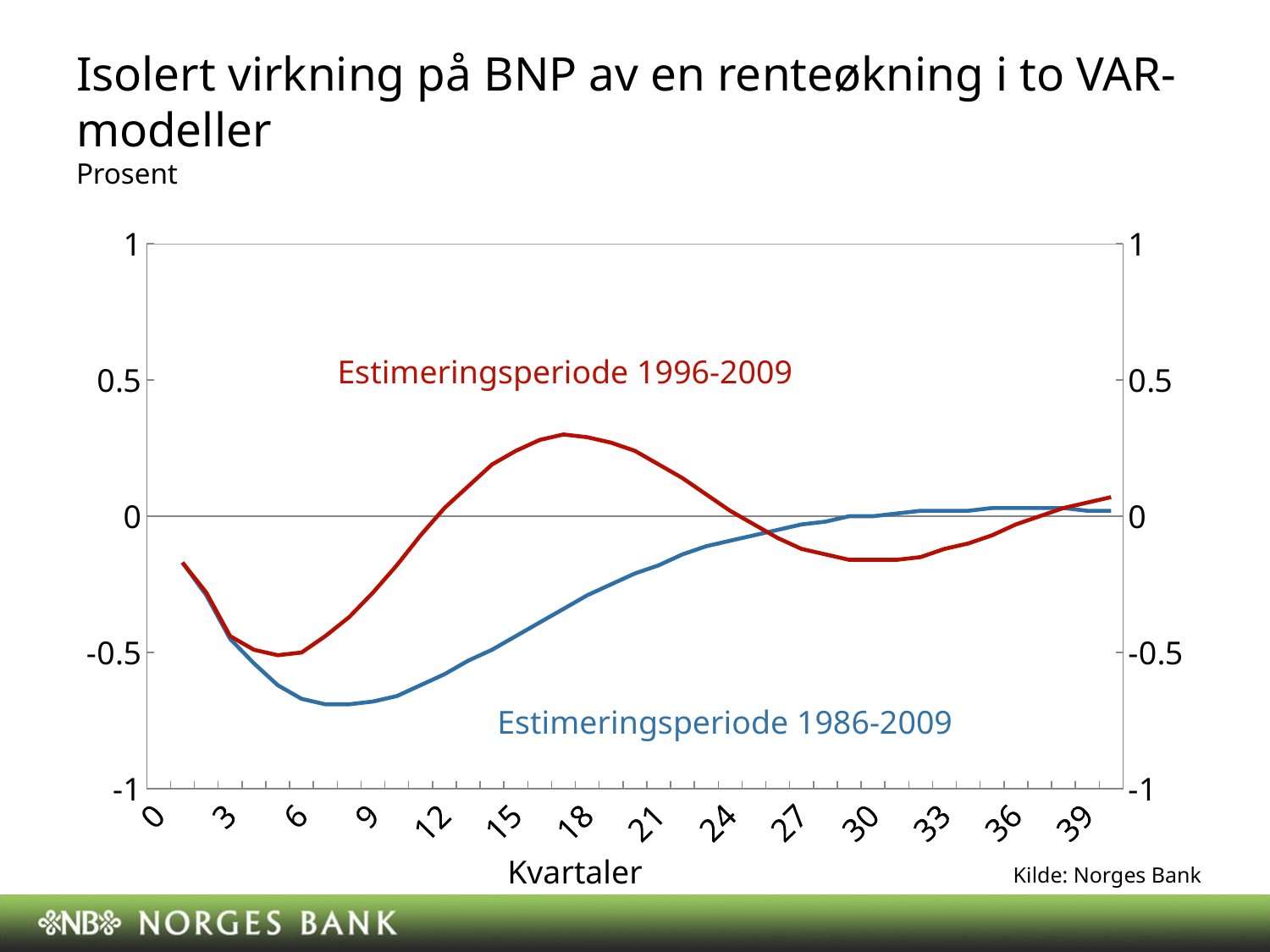
What is the label of the x axis? Kvartaler Is the value of the blue line (Estimeringsperiode 1986-2009) at quarter 12 greater or less than -0.5? less Which estimation period does the red line represent? Estimeringsperiode 1996-2009 Is the lowest value of the blue line (Estimeringsperiode 1986-2009) greater or less than -0.5? less Is the value of the red line (Estimeringsperiode 1996-2009) at quarter 30 greater or less than 0? less Does the blue line (Estimeringsperiode 1986-2009) rise or fall between quarter 9 and quarter 24? rise Which series reaches the lowest value on the chart? Estimeringsperiode 1986-2009 At quarter 30, which line has the higher value, the red (1996-2009) or the blue (1986-2009)? blue (1986-2009) What kind of chart is shown on the slide? line chart How many series are plotted on the chart? 2 At quarter 17, which line has the higher value, the red (1996-2009) or the blue (1986-2009)? red (1996-2009)